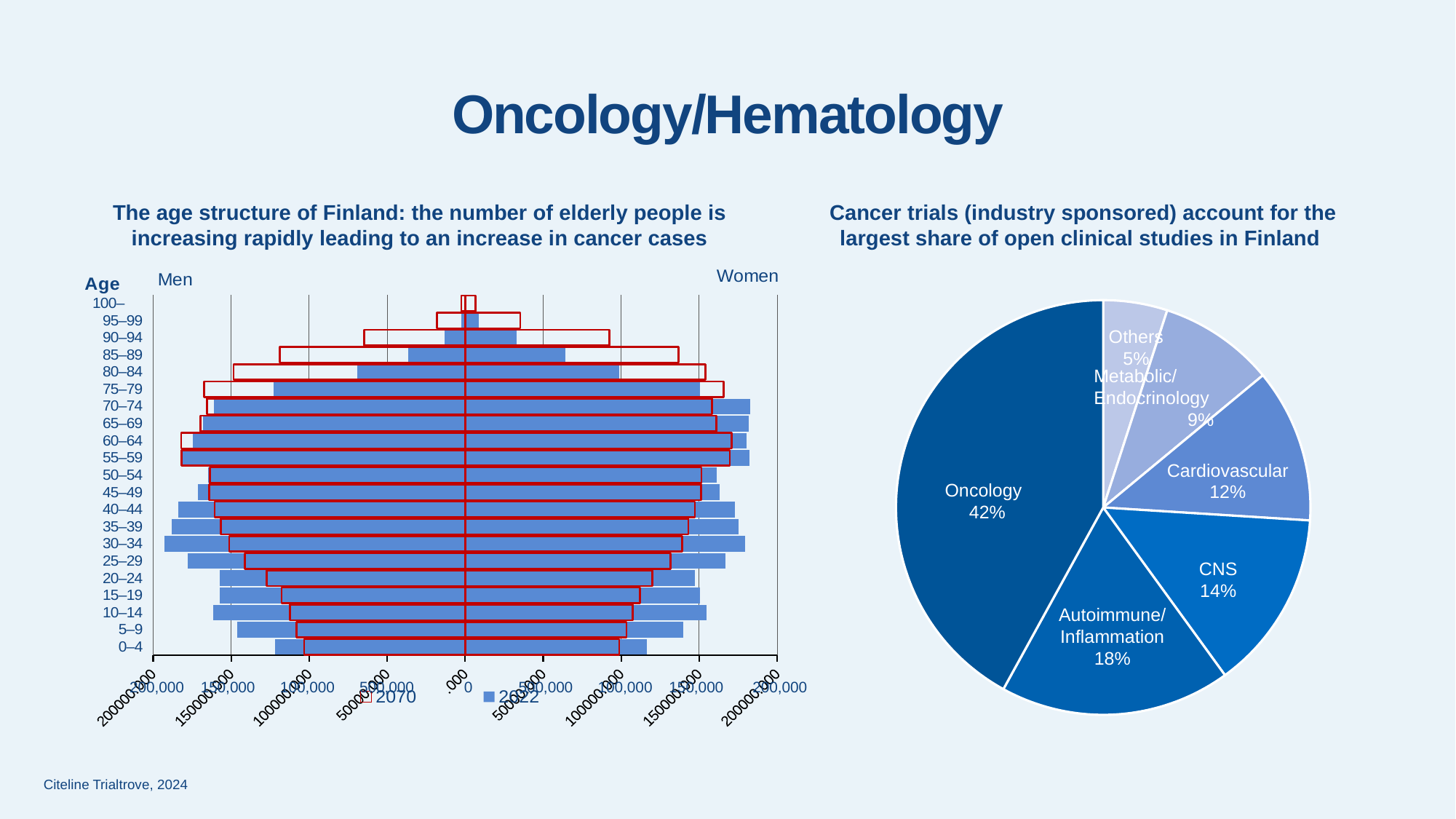
On the pie chart on the right, which has the larger share, Cardiovascular or Metabolic/Endocrinology? Cardiovascular On the pie chart on the right, which category has the smallest share? Others On the age structure chart on the left, is the 2022 value for men aged 30–34 greater or less than 150,000? greater On the pie chart on the right, how many percentage points larger is Oncology's share than Autoimmune/Inflammation's? 24 percentage points What kind of chart is shown on the right side of the slide? Pie chart What kind of chart is shown on the left side of the slide? Bar chart On the pie chart on the right, which category has the largest share? Oncology On the pie chart on the right, what is the share for CNS? 14% On the pie chart on the right, what share of open clinical studies does Oncology account for? 42% On the pie chart on the right, how many slices are there? 6 On the age structure chart on the left, how many series does the legend list? 2 On the pie chart on the right, what is the share for Autoimmune/Inflammation? 18%